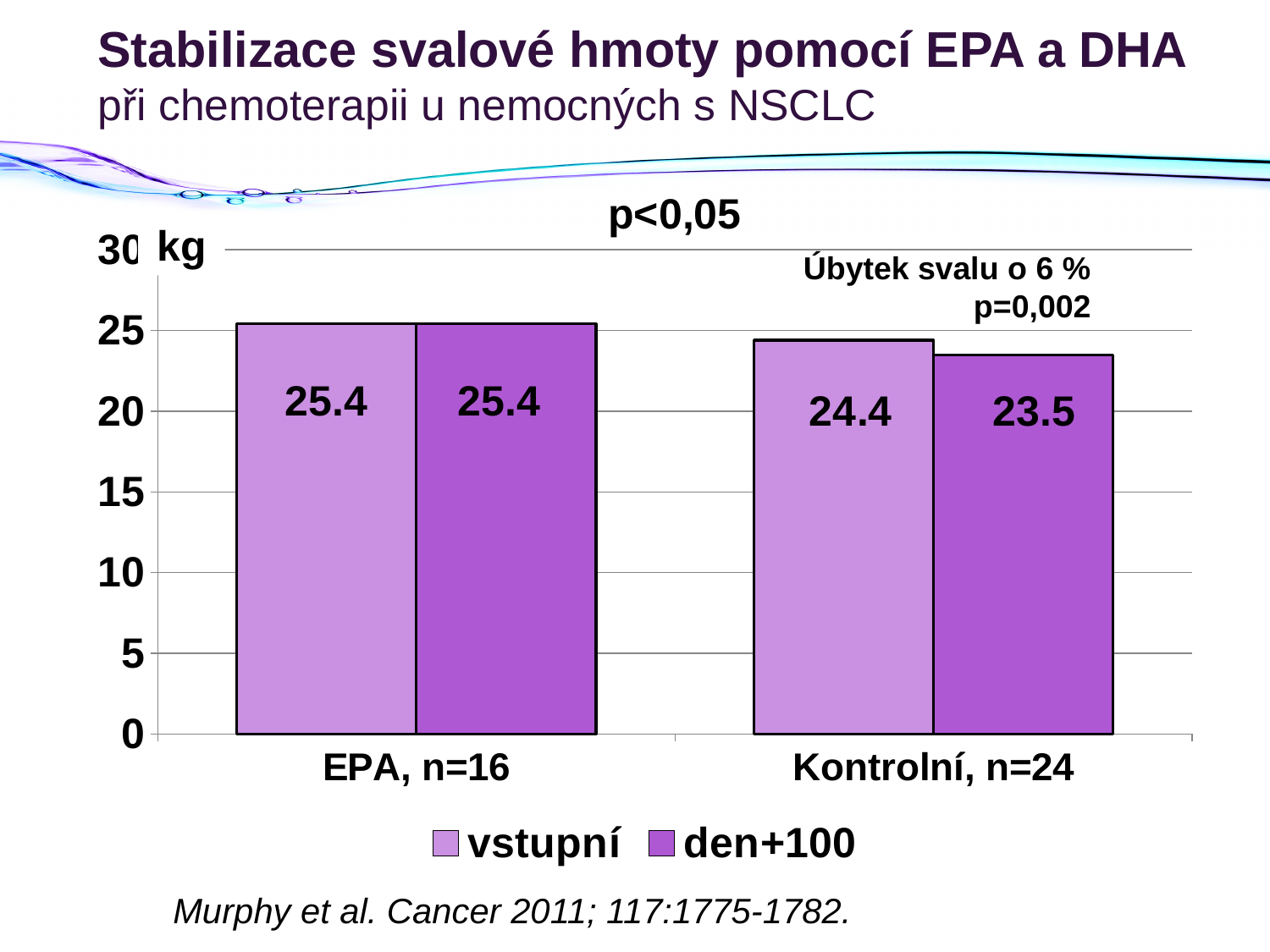
Is the den+100 value for Kontrolní, n=24 greater or less than 25? less What is the value for den+100 in the EPA, n=16 group? 25.4 What is the difference between the vstupní values of the EPA, n=16 and Kontrolní, n=24 groups? 1.0 How many series does the legend list? 2 What is the value for vstupní in the EPA, n=16 group? 25.4 What is the difference between the vstupní and den+100 values in the Kontrolní, n=24 group? 0.9 What kind of chart is shown on the slide? bar chart Which is larger: the den+100 value for EPA, n=16 or the den+100 value for Kontrolní, n=24? EPA, n=16 What is the value for vstupní in the Kontrolní, n=24 group? 24.4 What is the value for den+100 in the Kontrolní, n=24 group? 23.5 How many groups are shown on the x axis? 2 Which group has the lowest den+100 value? Kontrolní, n=24